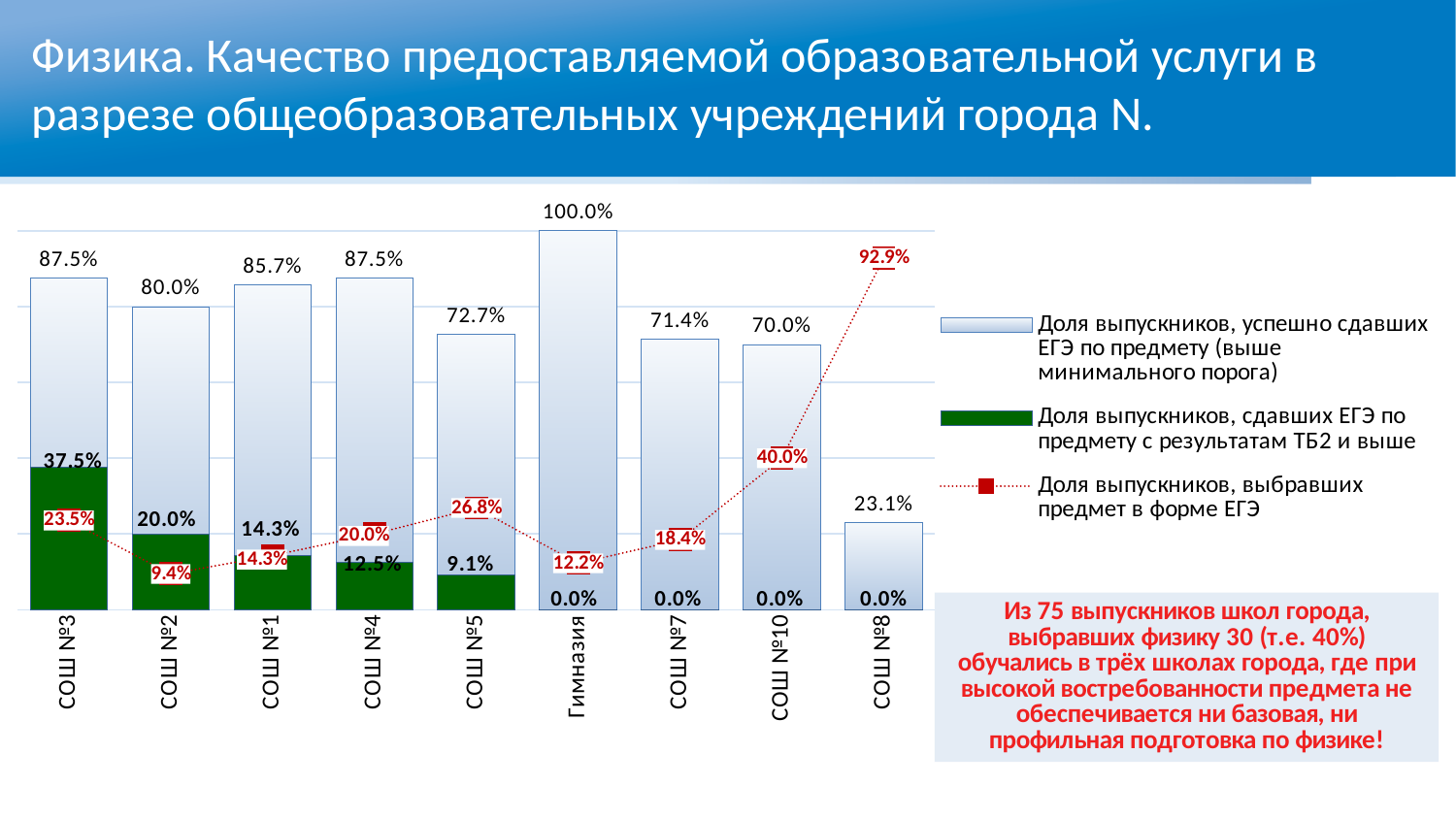
What is the share of graduates with a ТБ2-or-higher result for СОШ №10? 0.0% How many schools are shown on the x axis of the chart? 9 How many series does the chart legend list? 3 What kind of chart is shown on the slide? Bar chart with a line series What colour are the bars for the share of graduates with a ТБ2-or-higher result? Green What is the share of graduates who chose physics in the exam form for СОШ №8? 92.9% What is the difference between the share of graduates who passed above the minimum threshold at СОШ №2 and at СОШ №10? 10.0% What is the share of graduates who successfully passed the exam (above the minimum threshold) for Гимназия? 100.0% Which school has the highest share of graduates who chose physics in the exam form? СОШ №8 What is the share of graduates with a ТБ2-or-higher result for СОШ №3? 37.5% Which school has the lowest share of graduates who successfully passed the exam (above the minimum threshold)? СОШ №8 Which is larger: the share of graduates who chose physics at СОШ №5 or at СОШ №7? СОШ №5